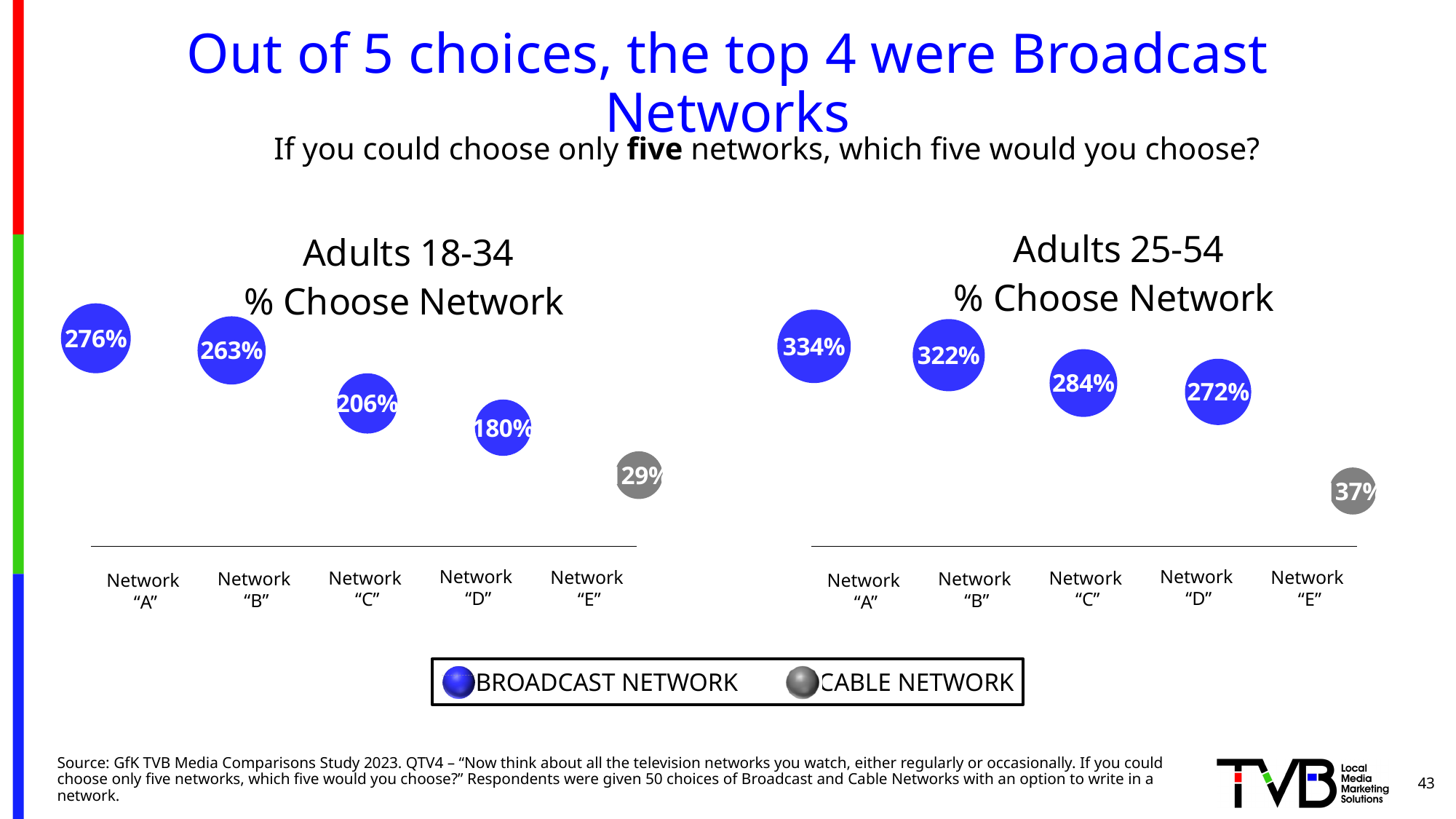
How many networks are shown in the Adults 18-34 chart? 5 In the Adults 18-34 chart, which network has the lowest value? Network "E" In the Adults 25-54 chart, what is the value for Network "C"? 284% In the Adults 25-54 chart, which network has the highest value? Network "A" Which is larger: the value for Network "D" in the Adults 18-34 chart or the value for Network "D" in the Adults 25-54 chart? Adults 25-54 Do the values in the Adults 25-54 chart rise or fall from Network "A" to Network "E"? fall In the Adults 18-34 chart, what is the value for Network "E"? 29% According to the legend, what colour represents a Cable Network? grey In the Adults 25-54 chart, what is the difference between the values for Network "A" and Network "B"? 12% How many series does the legend list? 2 In the Adults 18-34 chart, what is the difference between the values for Network "C" and Network "D"? 26% In the Adults 18-34 chart, what is the value for Network "A"? 276%